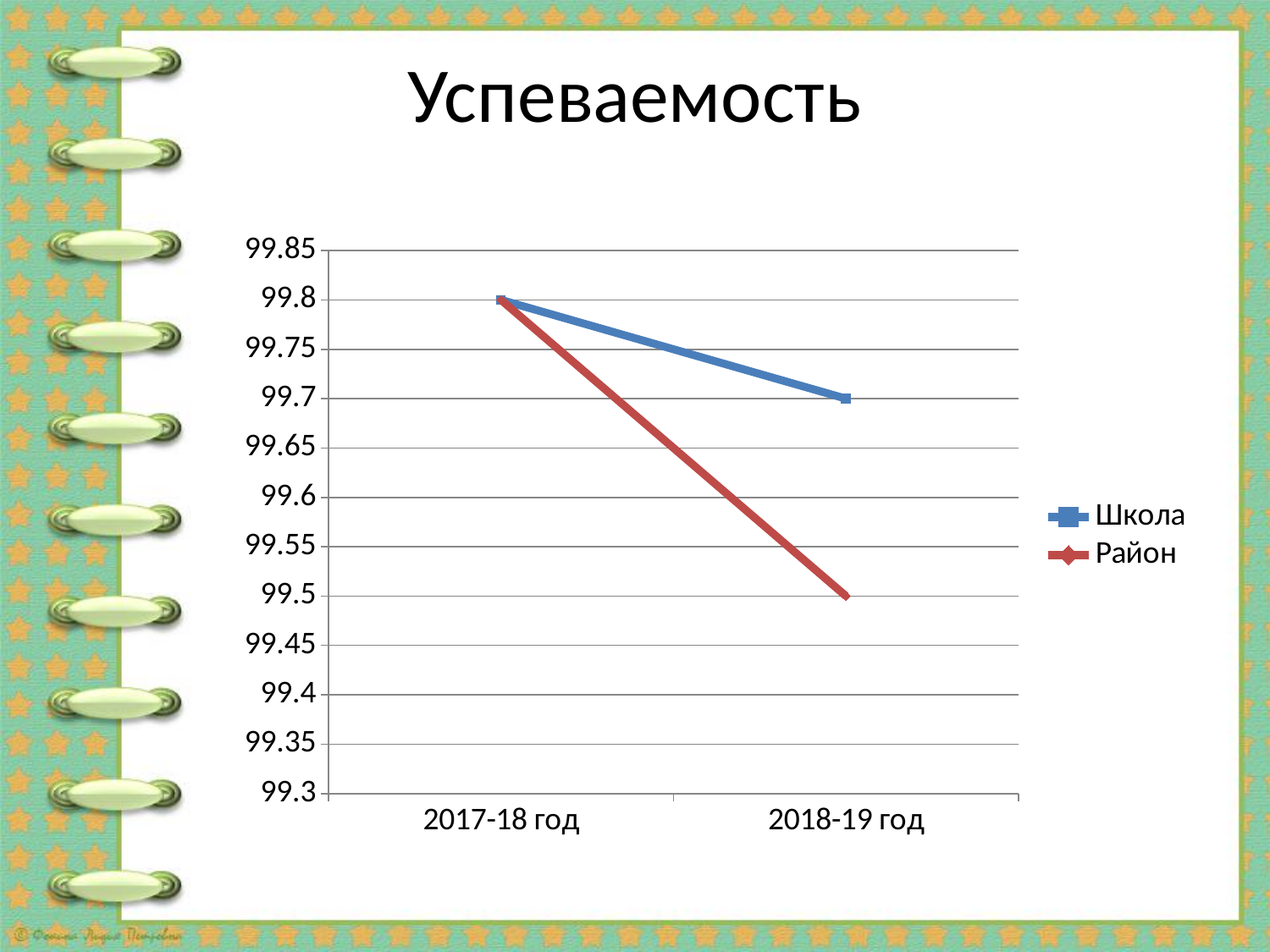
By how much did the Район value drop from 2017-18 год to 2018-19 год? 0.3 What is the difference between the Школа and Район values in 2018-19 год? 0.2 Does the Район line rise or fall from 2017-18 год to 2018-19 год? fall How many series does the legend list? 2 Which series has the higher value in 2018-19 год, Школа or Район? Школа What is the title of the chart? Успеваемость What is the value for Район in 2018-19 год? 99.5 Which colour is used for the Район series? red What kind of chart is shown on the slide? line chart How many points are plotted along the x axis for each series? 2 What is the value for Школа in 2018-19 год? 99.7 What is the value for Школа in 2017-18 год? 99.8